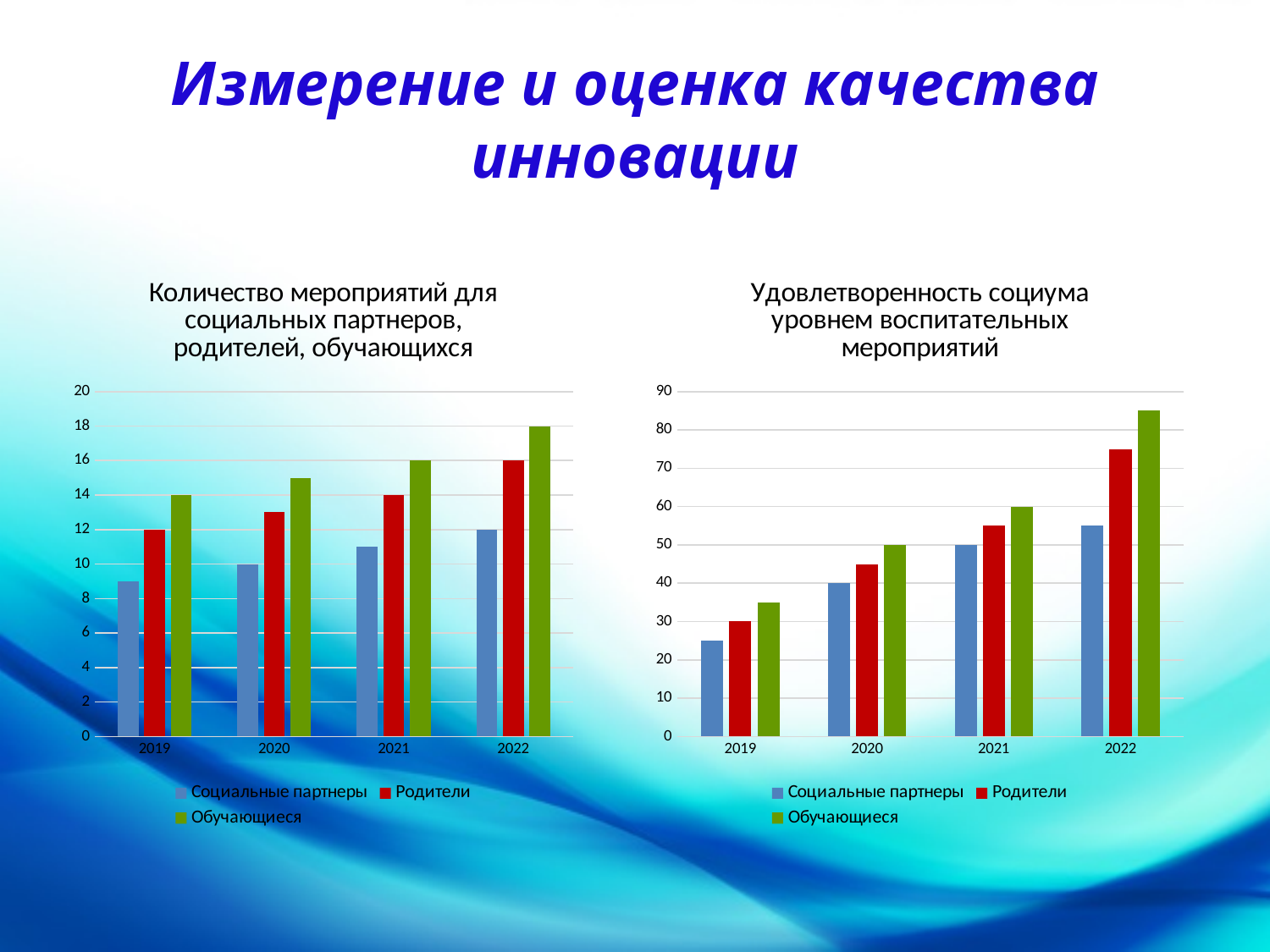
In the right chart (Удовлетворенность социума уровнем воспитательных мероприятий), what is the value for Родители in 2019? 30 In the right chart (Удовлетворенность социума уровнем воспитательных мероприятий), is the value for Обучающиеся in 2022 greater or less than 80? greater How many series does the legend of the right chart (Удовлетворенность социума уровнем воспитательных мероприятий) list? 3 In the right chart (Удовлетворенность социума уровнем воспитательных мероприятий), which series has the lowest value in 2019? Социальные партнеры In the left chart (Количество мероприятий для социальных партнеров, родителей, обучающихся), what is the difference between Обучающиеся and Социальные партнеры in 2022? 6 In the right chart (Удовлетворенность социума уровнем воспитательных мероприятий), what is the value for Обучающиеся in 2021? 60 In the left chart (Количество мероприятий для социальных партнеров, родителей, обучающихся), which year has the highest value for Обучающиеся? 2022 In the left chart (Количество мероприятий для социальных партнеров, родителей, обучающихся), does the value for Родители rise or fall from 2019 to 2022? rise In the left chart (Количество мероприятий для социальных партнеров, родителей, обучающихся), what is the value for Социальные партнеры in 2020? 10 In the left chart (Количество мероприятий для социальных партнеров, родителей, обучающихся), what is the value for Родители in 2019? 12 In the left chart (Количество мероприятий для социальных партнеров, родителей, обучающихся), is the value for Социальные партнеры in 2019 greater or less than 10? less In the left chart (Количество мероприятий для социальных партнеров, родителей, обучающихся), what is the value for Обучающиеся in 2022? 18